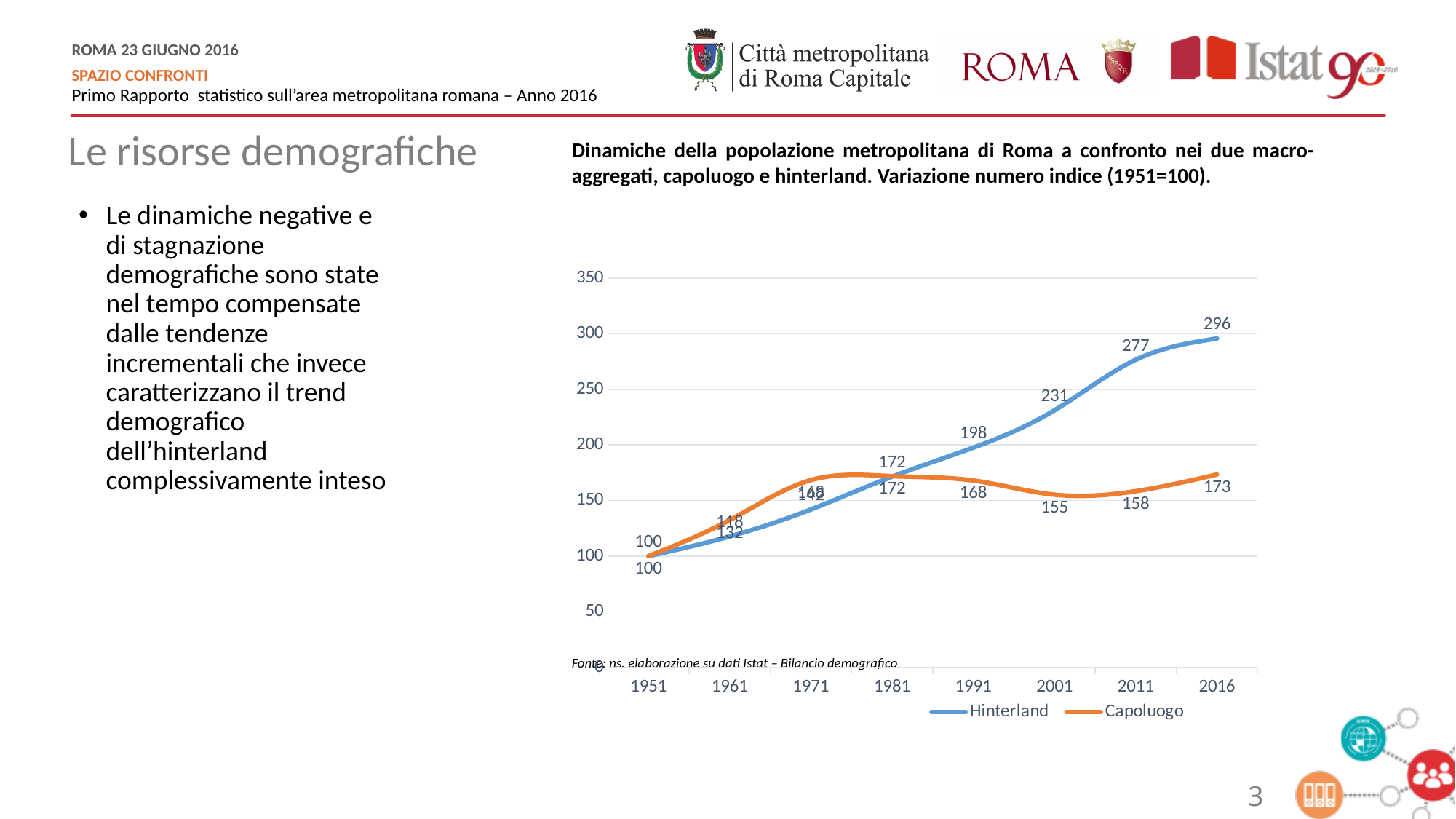
What is the value for Capoluogo in 2016? 173 Which series has the larger value in 2001, Hinterland or Capoluogo? Hinterland How many series does the legend list? 2 What is the value for Hinterland in 2011? 277 What is the value for Hinterland in 2016? 296 What is the value for Capoluogo in 2001? 155 In which year does the Hinterland series reach its highest value? 2016 What type of chart is shown on the slide? line chart How many years are shown on the x axis? 8 What is the value for Hinterland in 1991? 198 Does the Hinterland series rise or fall from 1951 to 2016? rise What is the difference between Hinterland and Capoluogo in 2016? 123